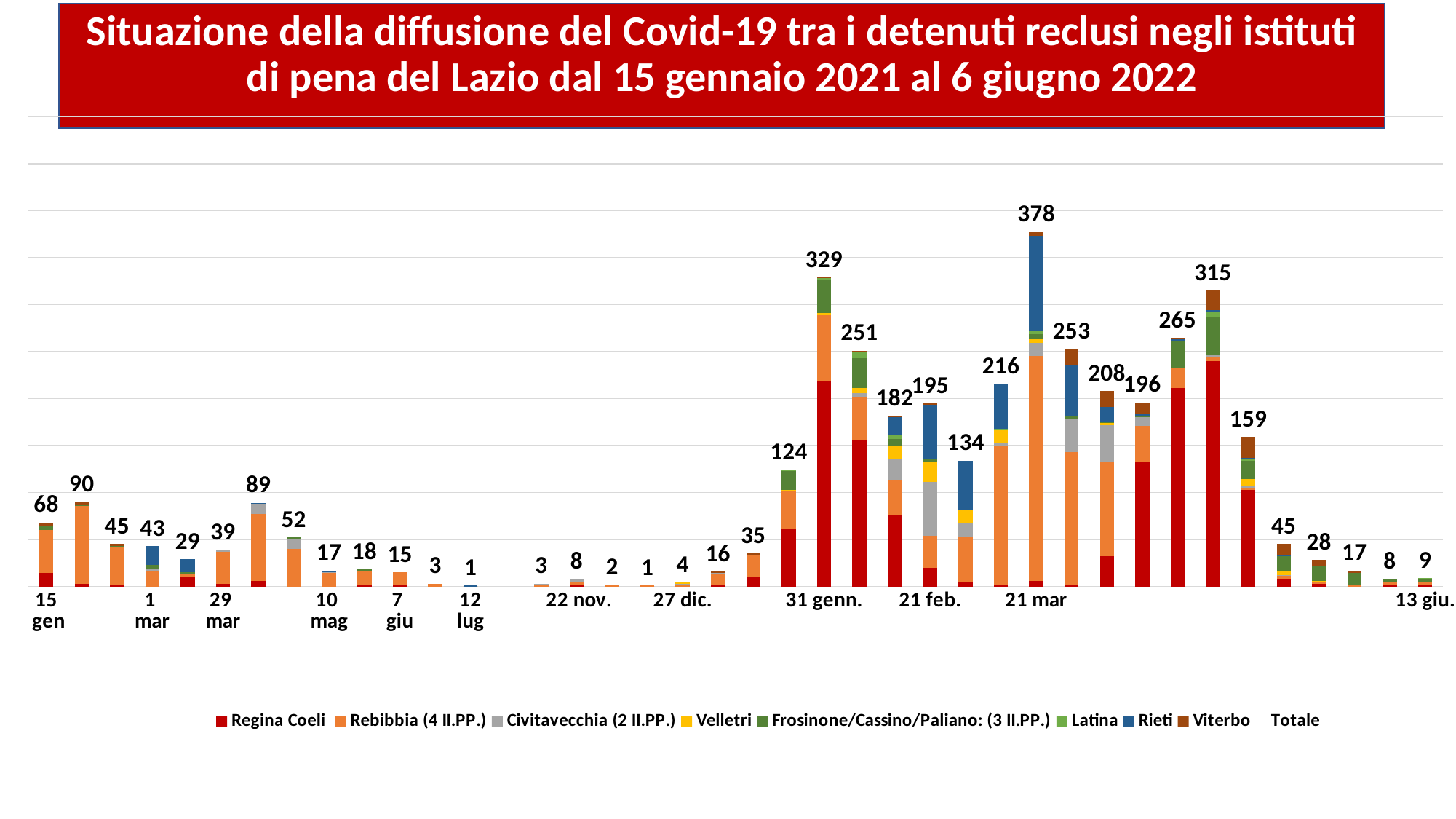
What is the total value labelled for the bar at 21 mar? 378 What is the difference between the total at 21 mar and the total at 31 genn.? 49 What kind of chart is shown on the slide? Stacked bar chart What is the total value labelled for the bar at 13 giu.? 9 What is the difference between the total at 21 mar and the total at 21 feb.? 183 What is the total value labelled for the bar at 15 gen? 68 What is the highest total value labelled on any bar in the chart? 378 What is the total value labelled for the bar at 12 lug? 1 Which colour represents Regina Coeli in the legend? Red What is the total value labelled for the bar at 31 genn.? 329 What is the total value labelled for the bar at 21 feb.? 195 Which bar has the larger total, 1 mar or 29 mar? 1 mar